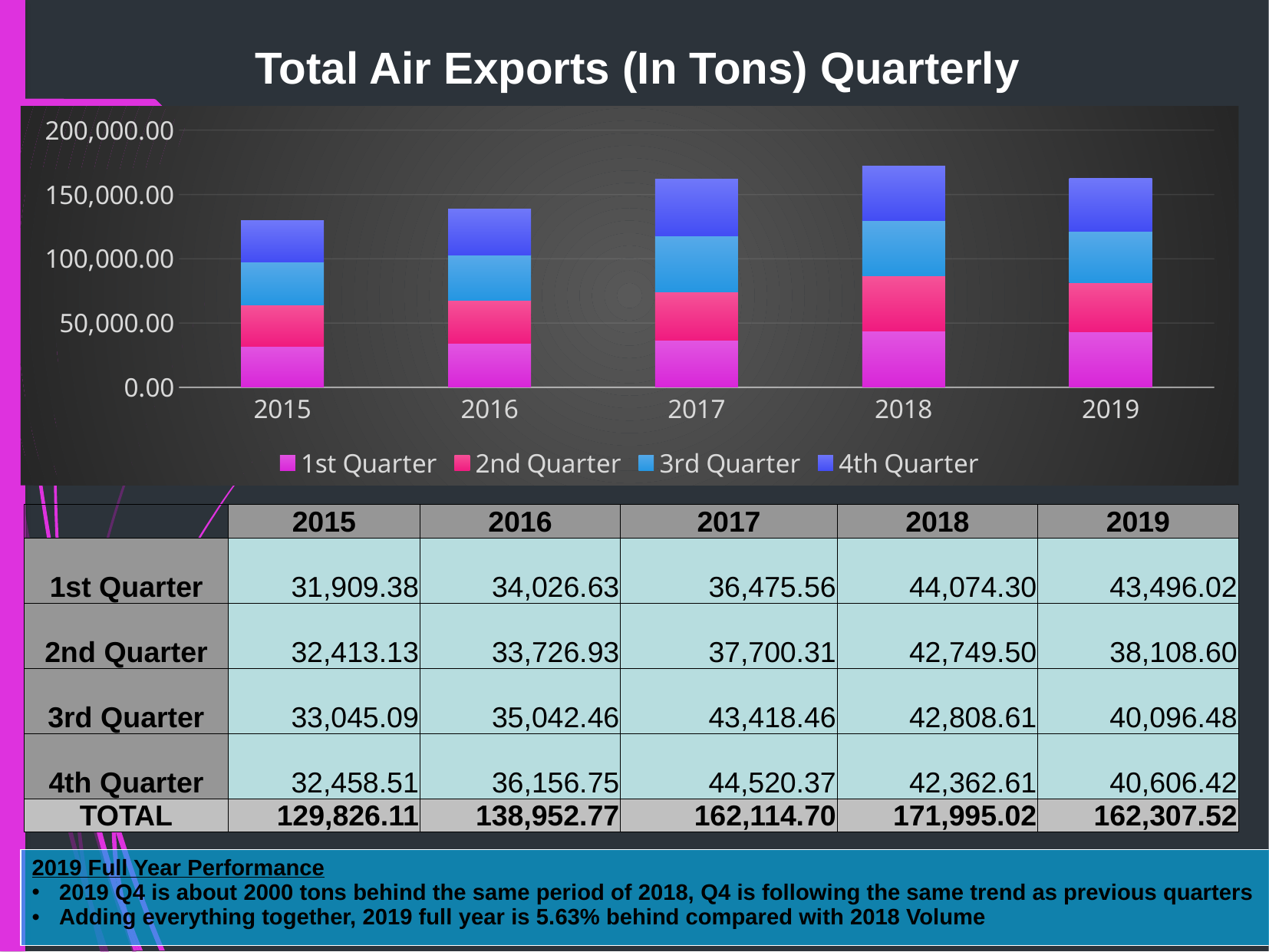
Which year has the lowest total air exports? 2015 How many series does the chart legend list? 4 What kind of chart is shown on the slide? Stacked bar chart Which year has the highest total air exports? 2018 What is the difference between the 2018 total and the 2019 total? 9,687.50 What is the 4th Quarter value for 2019? 40,606.42 What is the total air export volume for 2018? 171,995.02 Which is larger, the 3rd Quarter value for 2017 or for 2018? 2017 Is the total stacked bar for 2015 greater or less than 150,000.00? less What is the 1st Quarter value for 2017? 36,475.56 How many years are shown along the x axis of the chart? 5 How do the total air exports change from 2015 to 2019? Rise from 2015 to 2018, then fall in 2019